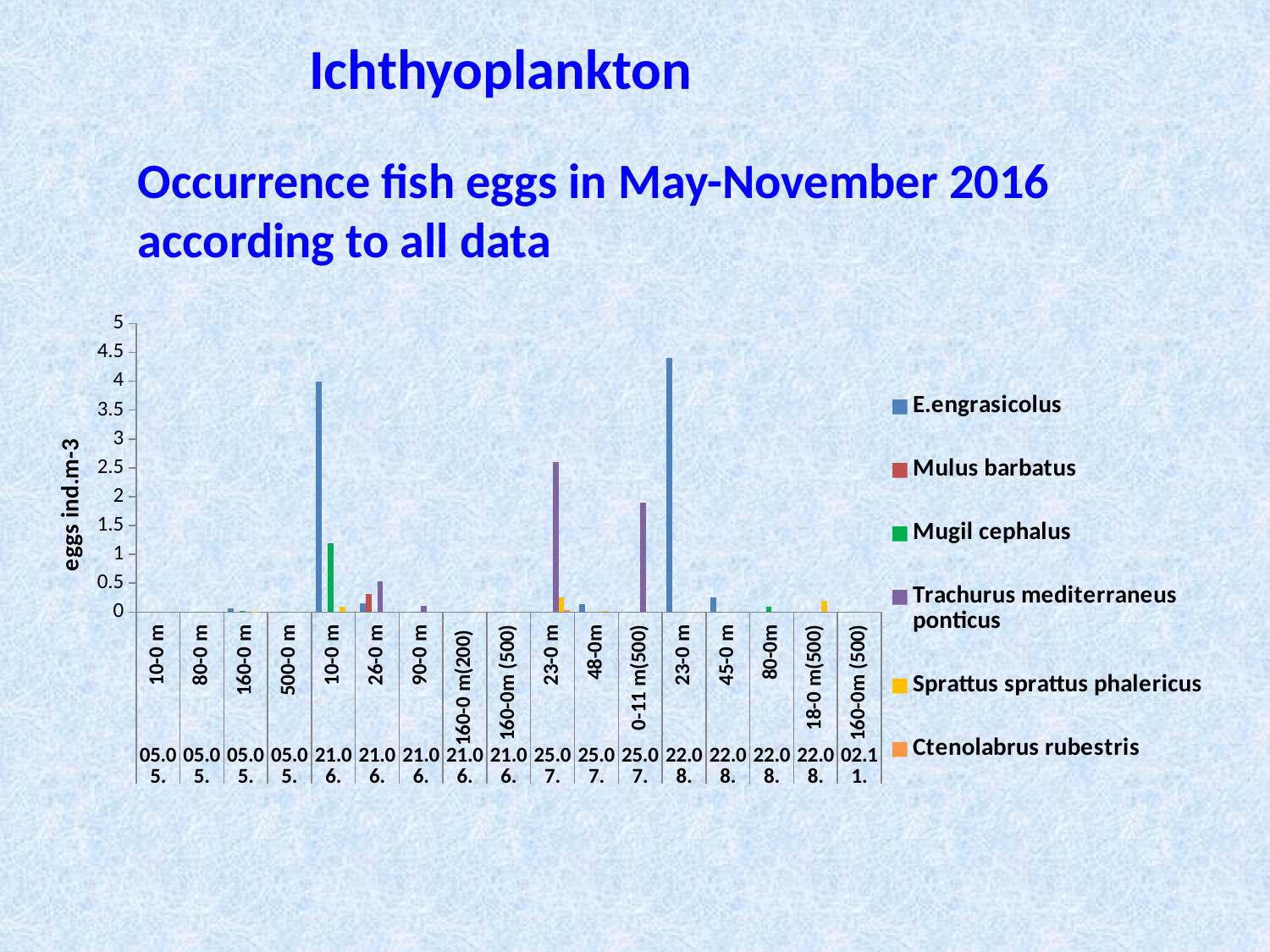
At which station and date does E.engrasicolus reach its highest value? 23-0 m, 22.08. Which is larger: the E.engrasicolus value at 23-0 m on 22.08. or the Trachurus mediterraneus ponticus value at 23-0 m on 25.07.? E.engrasicolus at 23-0 m on 22.08. How many series does the legend list? 6 Is the Trachurus mediterraneus ponticus value for 0-11 m(500) on 25.07. greater or less than 1.5? greater Is the Trachurus mediterraneus ponticus value for 23-0 m on 25.07. greater or less than 2? greater Which series is shown in green in the legend? Mugil cephalus How many categories (sampling stations) are shown along the x axis? 17 Is the E.engrasicolus value for 23-0 m on 22.08. greater or less than 4? greater What kind of chart is shown on the slide? bar chart What is the label of the vertical axis? eggs ind.m-3